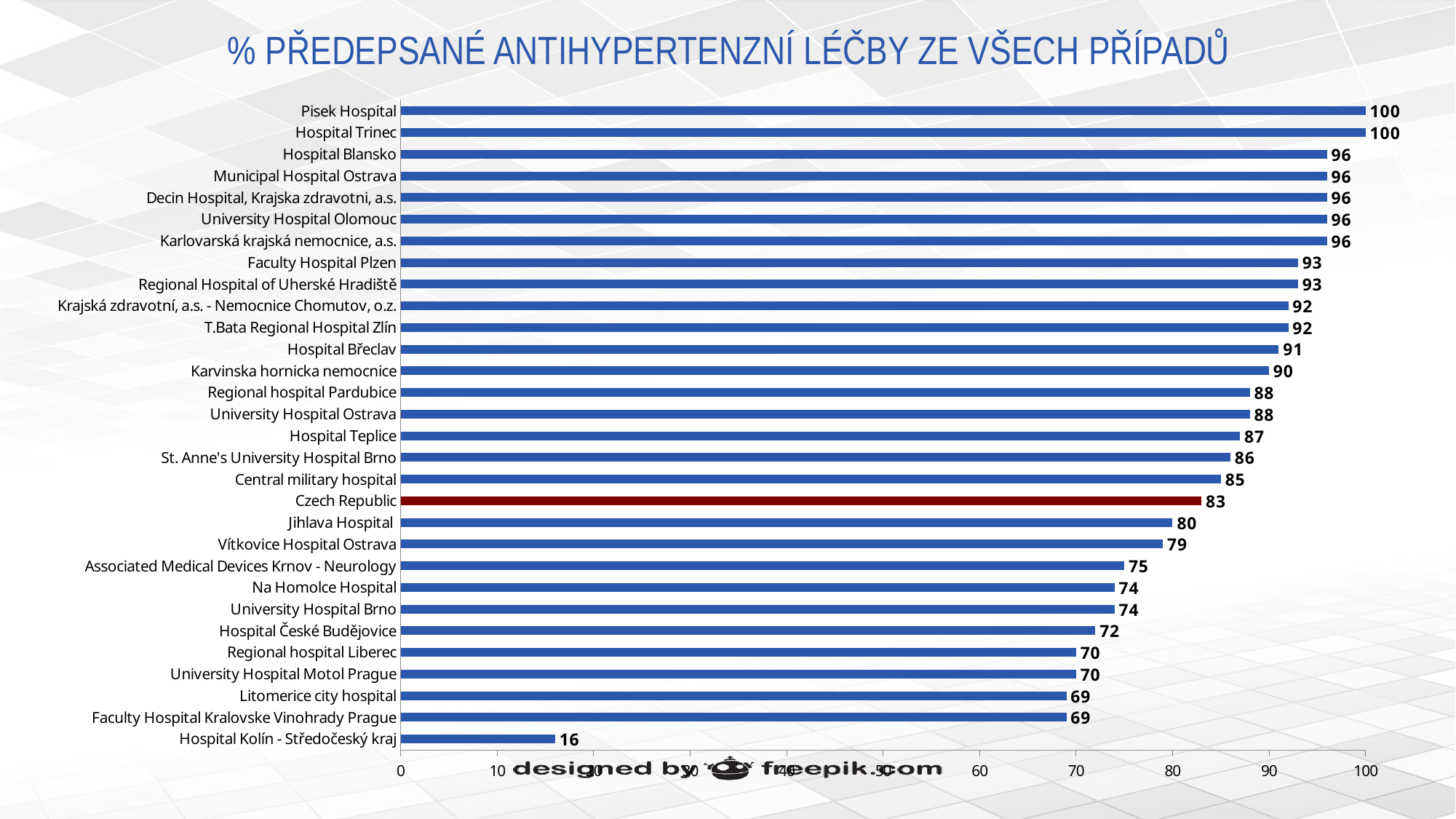
What is the value for Karvinska hornicka nemocnice? 90 What is the difference between the values for Faculty Hospital Plzen and Hospital Teplice? 6 What is the title of the chart? % PŘEDEPSANÉ ANTIHYPERTENZNÍ LÉČBY ZE VŠECH PŘÍPADŮ What is the difference between the values for Pisek Hospital and Czech Republic? 17 What is the value for Hospital Kolín - Středočeský kraj? 16 What kind of chart is shown on the slide? bar chart Which category has the lowest value? Hospital Kolín - Středočeský kraj Which is larger, the value for Jihlava Hospital or the value for Na Homolce Hospital? Jihlava Hospital What is the value for University Hospital Motol Prague? 70 How many categories are shown on the chart? 30 Which bar is coloured differently (dark red) from the others? Czech Republic What is the value for Czech Republic? 83